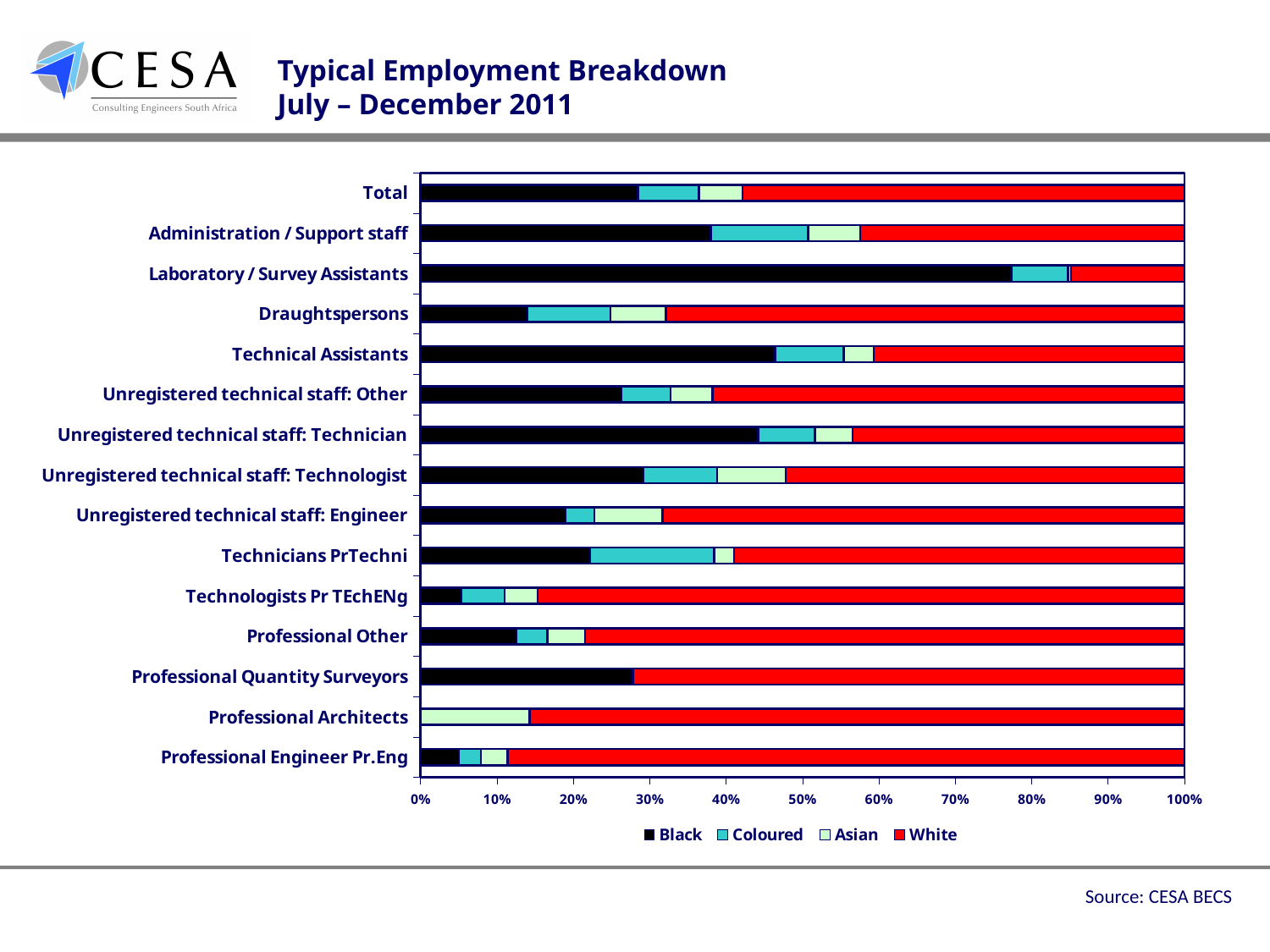
Which has the larger Black share: Technical Assistants or Draughtspersons? Technical Assistants Is the Black share for Technologists Pr TEchENg greater or less than 10%? less Which has the larger Black share: Unregistered technical staff: Technician or Unregistered technical staff: Other? Unregistered technical staff: Technician Which category has the smallest White share? Laboratory / Survey Assistants Is the White share for the Total bar greater or less than 50%? greater Which category shows no Black segment at all? Professional Architects Is the Black share for Laboratory / Survey Assistants greater or less than 70%? greater What is the title of the chart on the slide? Typical Employment Breakdown July – December 2011 What kind of chart is shown on the slide? Stacked bar chart Which category has the largest Black share? Laboratory / Survey Assistants How many employment categories are plotted on the chart? 15 How many series does the legend list? 4